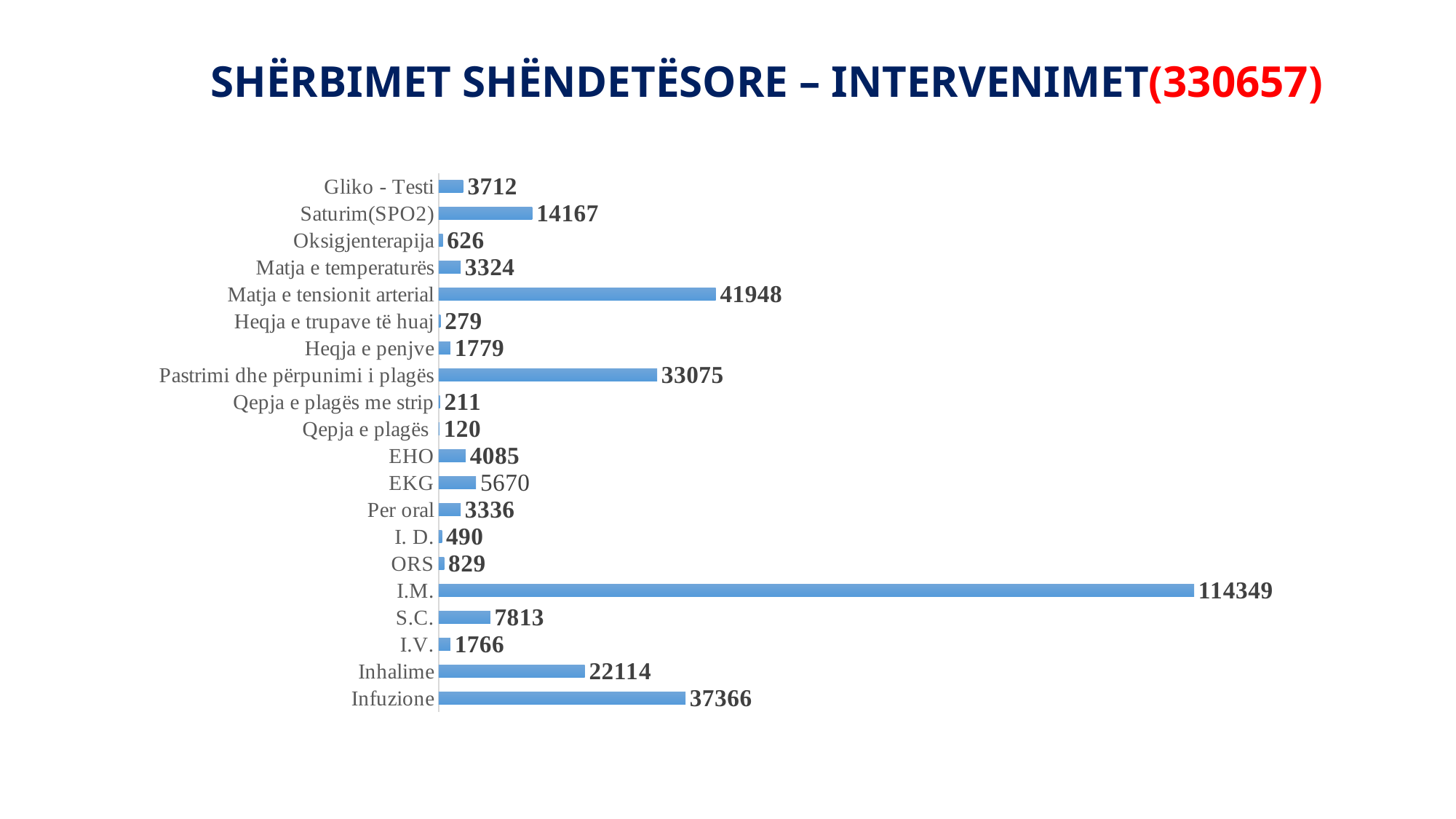
Which category has the lowest value? Qepja e plagës What is the value for Infuzione? 37366 How many categories are shown in the chart? 20 What is the value for Matja e tensionit arterial? 41948 What number is shown in red in the slide title? 330657 Which category has the highest value? I.M. Which is larger, the value for Inhalime or the value for Pastrimi dhe përpunimi i plagës? Pastrimi dhe përpunimi i plagës What is the value for EKG? 5670 What kind of chart is shown on the slide? Bar chart What is the difference between the values for I.M. and Matja e tensionit arterial? 72401 What is the difference between the values for Matja e tensionit arterial and Infuzione? 4582 What is the value for Saturim(SPO2)? 14167